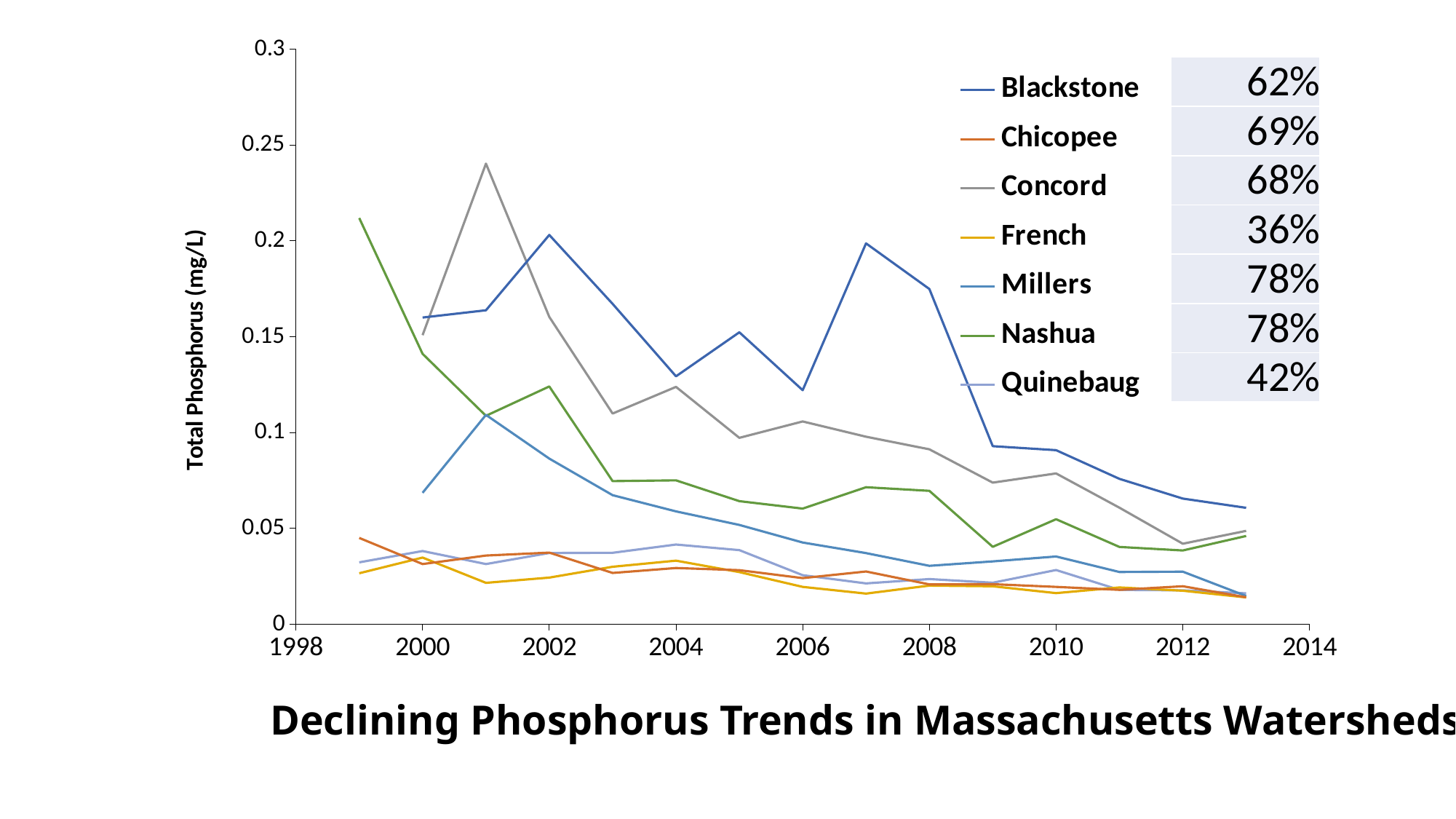
Is the value for Blackstone in 2013 greater or less than 0.05? greater In which year does Concord reach its peak value? 2001 Which is higher in 2001, Blackstone or Concord? Concord How many series does the legend list? 7 Which series has the highest value in 2013? Blackstone What percentage is printed next to Millers in the legend? 78% Does the Blackstone series generally rise or fall from 2000 to 2013? fall What kind of chart is shown on the slide? line chart Which series reaches the highest value anywhere on the chart? Concord Is the value for Concord in 2001 greater or less than 0.2? greater Is the value for Blackstone in 2009 greater or less than 0.1? less